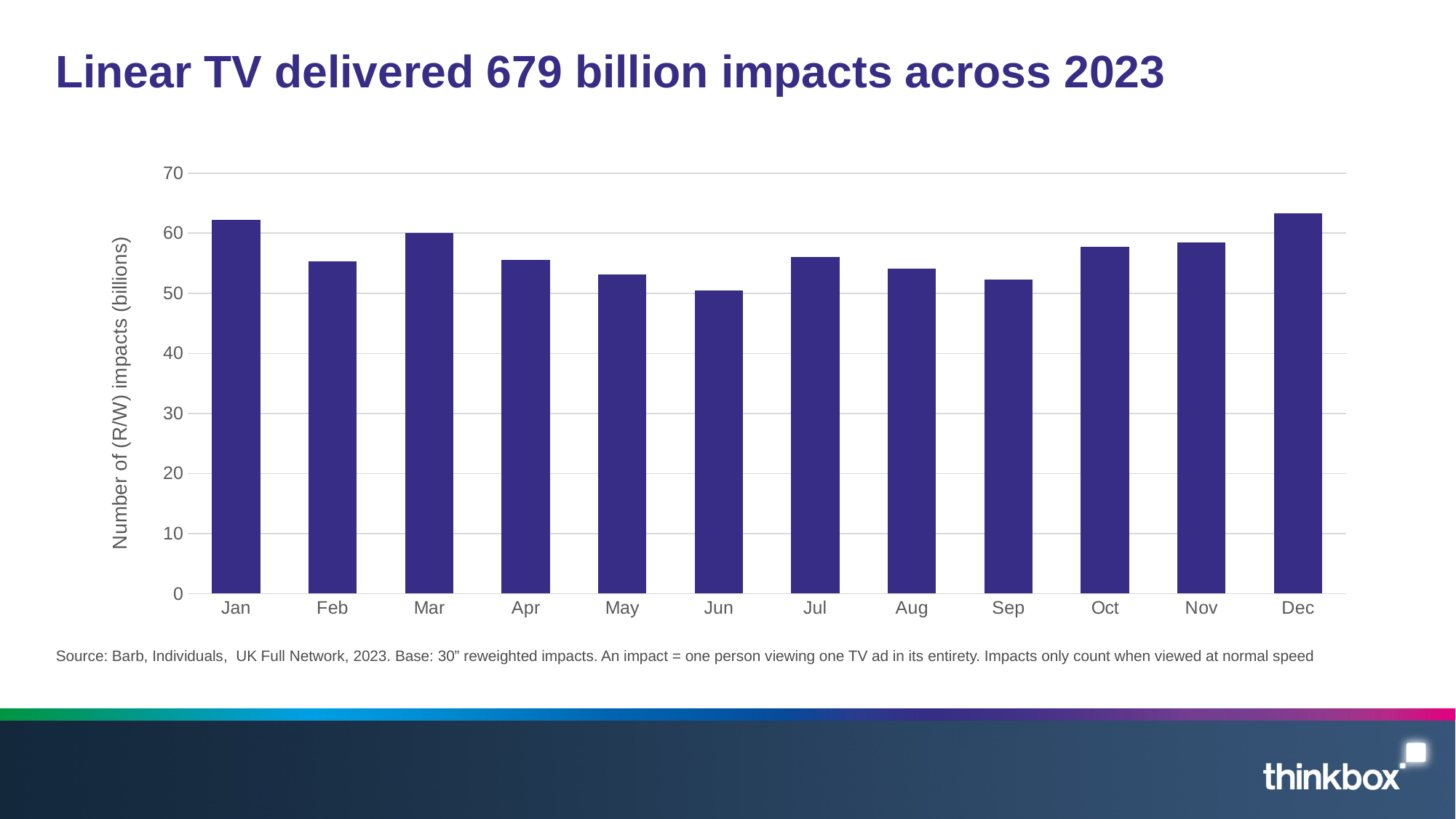
Is the value for Dec greater or less than 60? greater What kind of chart is shown on the slide? Bar chart What is the label on the vertical axis of the chart? Number of (R/W) impacts (billions) Do the values rise or fall from Sep to Dec? Rise Is the value for May greater or less than 50? greater Is the value for Feb greater or less than 60? less Which month has the lowest number of impacts? Jun Which is larger, the value for Jan or the value for Feb? Jan How many months are plotted on the chart? 12 Which is larger, the value for Dec or the value for Jun? Dec